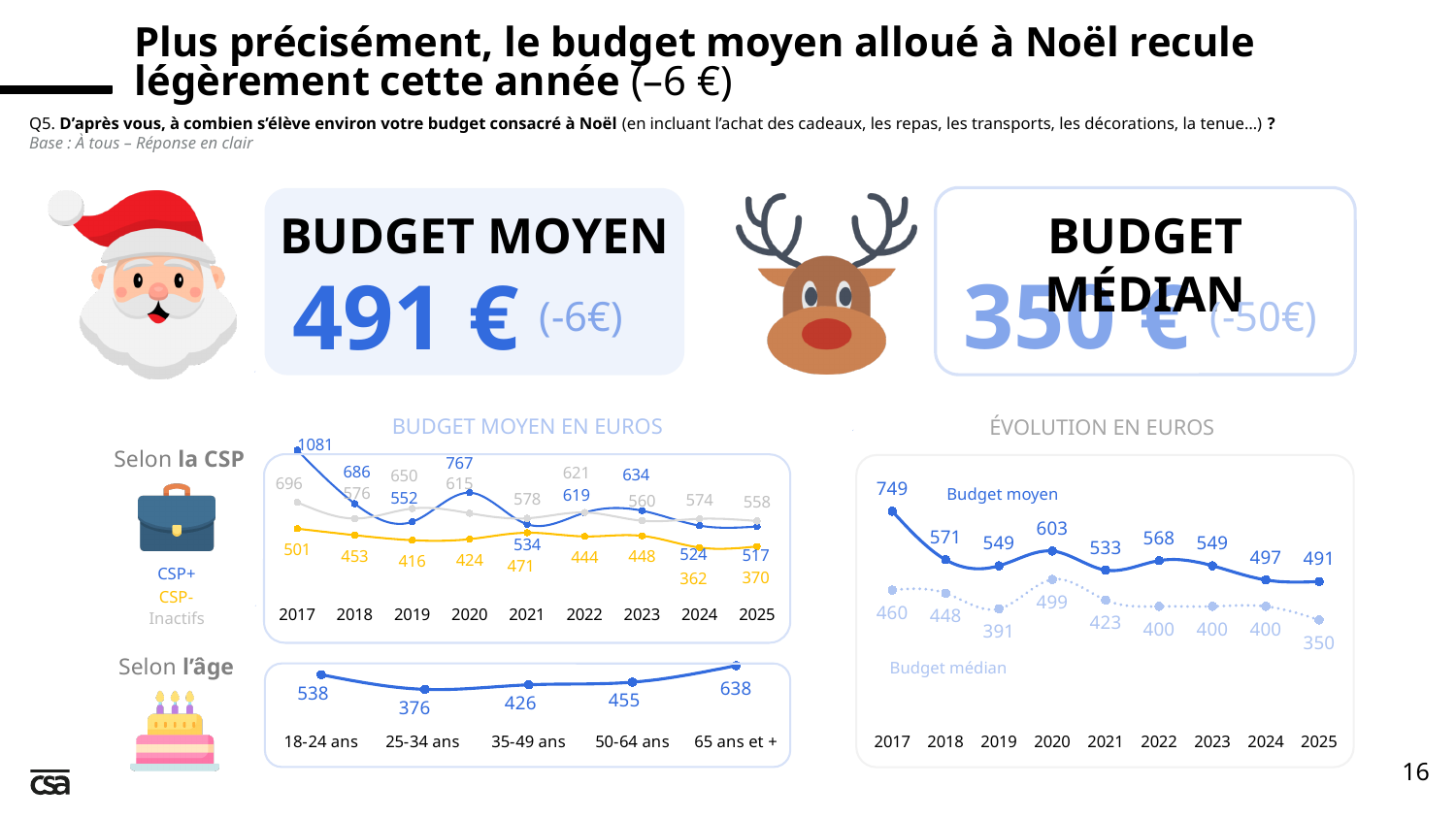
In the 'ÉVOLUTION EN EUROS' chart, what is the difference between the Budget moyen and the Budget médian in 2017? 289 In the 'ÉVOLUTION EN EUROS' chart, what is the Budget moyen value for 2020? 603 In the 'Selon l'âge' chart, what is the average budget for the 25-34 ans group? 376 In the 'Selon l'âge' chart, which age group has the highest average budget? 65 ans et + In the 'ÉVOLUTION EN EUROS' chart, in which year is the Budget moyen highest? 2017 In the 'ÉVOLUTION EN EUROS' chart, what is the Budget médian value for 2025? 350 In the 'Selon la CSP' chart, what is the CSP- value for 2024? 362 In the 'Selon la CSP' chart, what is the CSP+ value for 2017? 1081 In the 'Selon l'âge' chart, which age group has the lowest average budget? 25-34 ans In the 'ÉVOLUTION EN EUROS' chart, how many series are shown? 2 In the 'Selon l'âge' chart, how many age groups are shown? 5 What type of chart is the 'ÉVOLUTION EN EUROS' chart? Line chart